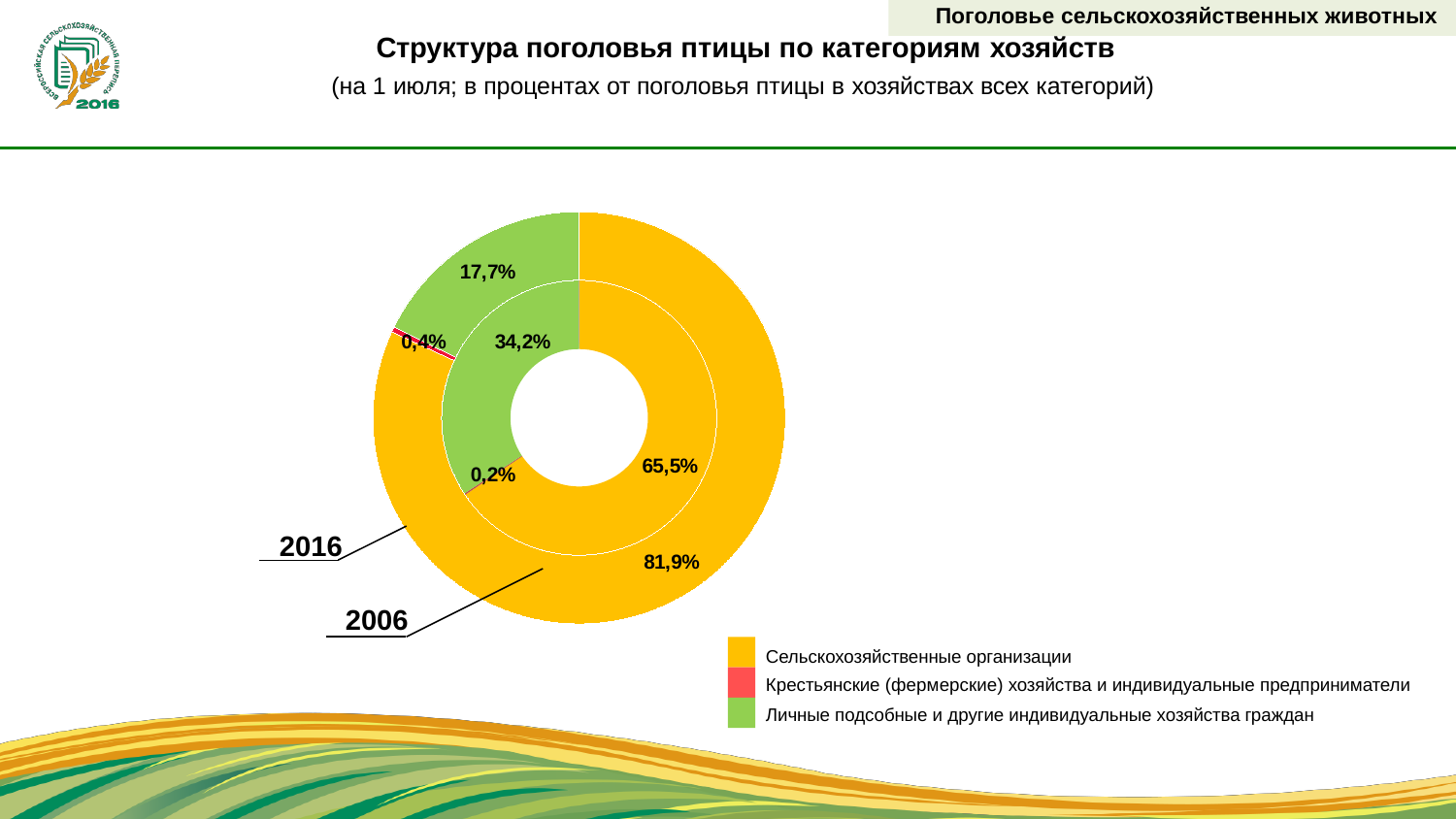
What share did peasant (farm) households and individual entrepreneurs (Крестьянские (фермерские) хозяйства и индивидуальные предприниматели) hold in 2006? 0,2% Which category had the largest share of the poultry stock in 2016? Сельскохозяйственные организации What share did peasant (farm) households and individual entrepreneurs (Крестьянские (фермерские) хозяйства и индивидуальные предприниматели) hold in 2016? 0,4% What share of the poultry stock did agricultural organisations (Сельскохозяйственные организации) hold in 2006? 65,5% Which category had the smallest share of the poultry stock in 2006? Крестьянские (фермерские) хозяйства и индивидуальные предприниматели Was the share of personal subsidiary households larger in 2006 or in 2016? 2006 What share did personal subsidiary and other individual households (Личные подсобные и другие индивидуальные хозяйства граждан) hold in 2006? 34,2% What share of the poultry stock did agricultural organisations (Сельскохозяйственные организации) hold in 2016? 81,9% What share did personal subsidiary and other individual households (Личные подсобные и другие индивидуальные хозяйства граждан) hold in 2016? 17,7% What kind of chart is shown on the slide? Doughnut chart By how many percentage points did the share of agricultural organisations change from 2006 to 2016? 16,4 How many categories does the legend list? 3